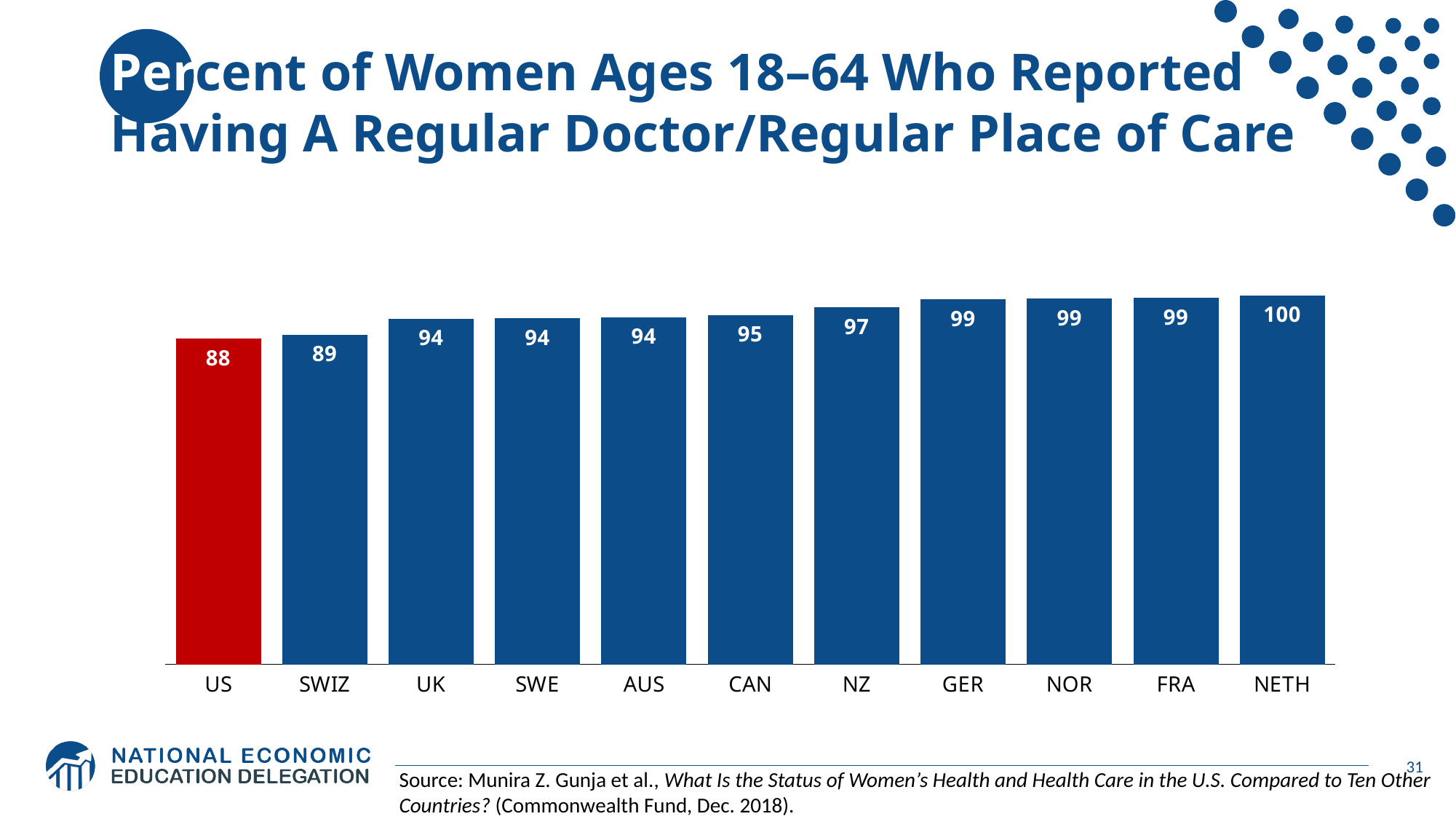
Do the values rise or fall from left to right across the chart? Rise What is the difference between the values for NETH and the US? 12 Which has a larger value, UK or NZ? NZ How many countries are shown in the chart? 11 What is the value for NZ? 97 What is the difference between the values for SWIZ and the US? 1 Which bar is coloured red rather than blue? US Which country has the highest value? NETH Which country has the lowest value? US What is the value for the US? 88 What kind of chart is shown on the slide? Bar chart What is the value for CAN? 95